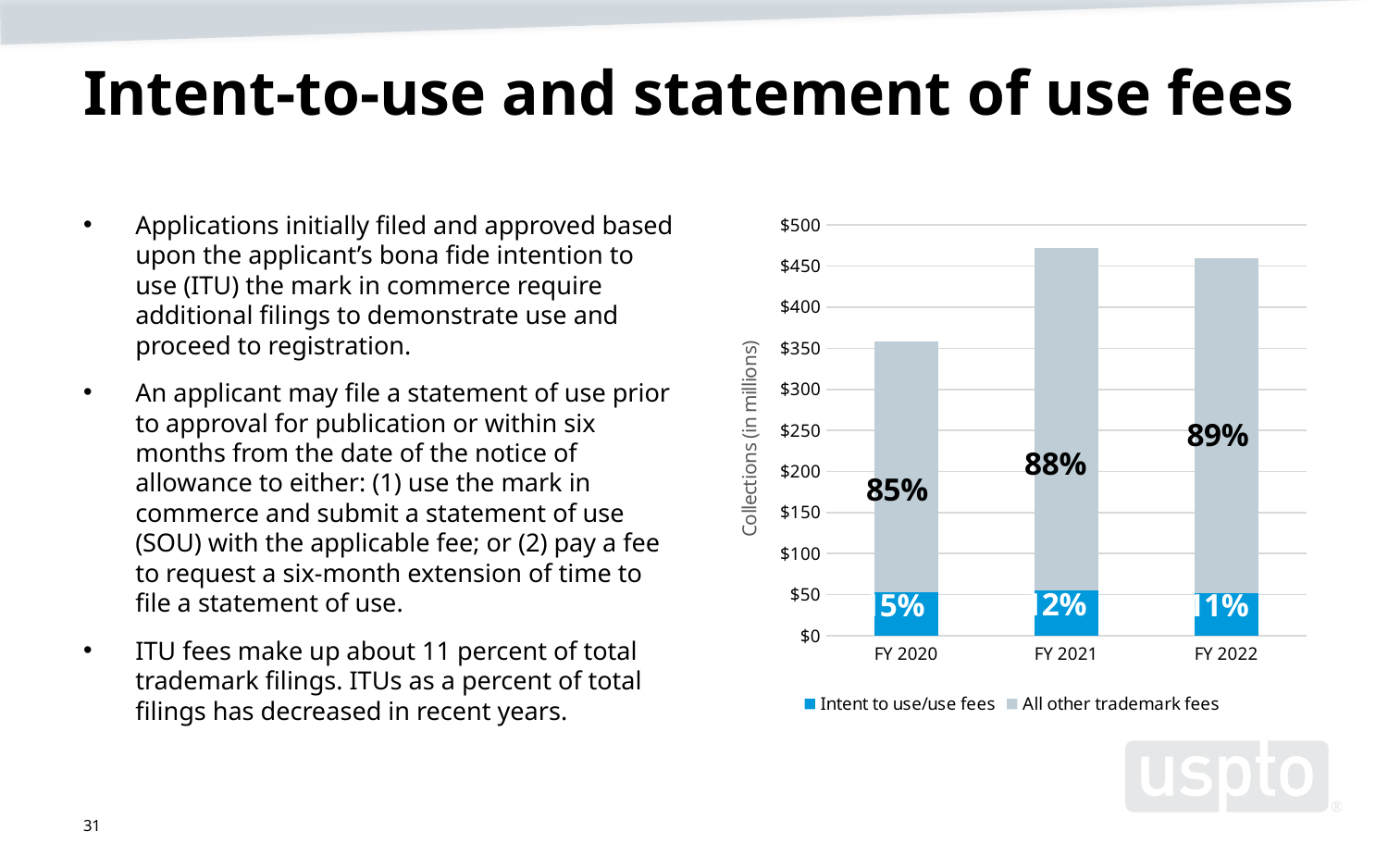
By how many percentage points does the 'All other trademark fees' share in FY 2022 exceed that in FY 2020? 4 percentage points Is the total collections bar for FY 2021 greater or less than $450? greater In which fiscal year is the 'All other trademark fees' percentage the lowest? FY 2020 What kind of chart is shown on the slide? Stacked bar chart How many fiscal years are shown on the x axis of the chart? 3 How many series does the chart's legend list? 2 What is the label on the vertical axis of the chart? Collections (in millions) What percentage label is shown on the 'All other trademark fees' segment for FY 2022? 89% Is the total collections bar for FY 2020 greater or less than $400? less What percentage label is shown on the 'All other trademark fees' segment for FY 2020? 85% What percentage label is shown on the 'All other trademark fees' segment for FY 2021? 88% In which fiscal year is the 'All other trademark fees' percentage the highest? FY 2022